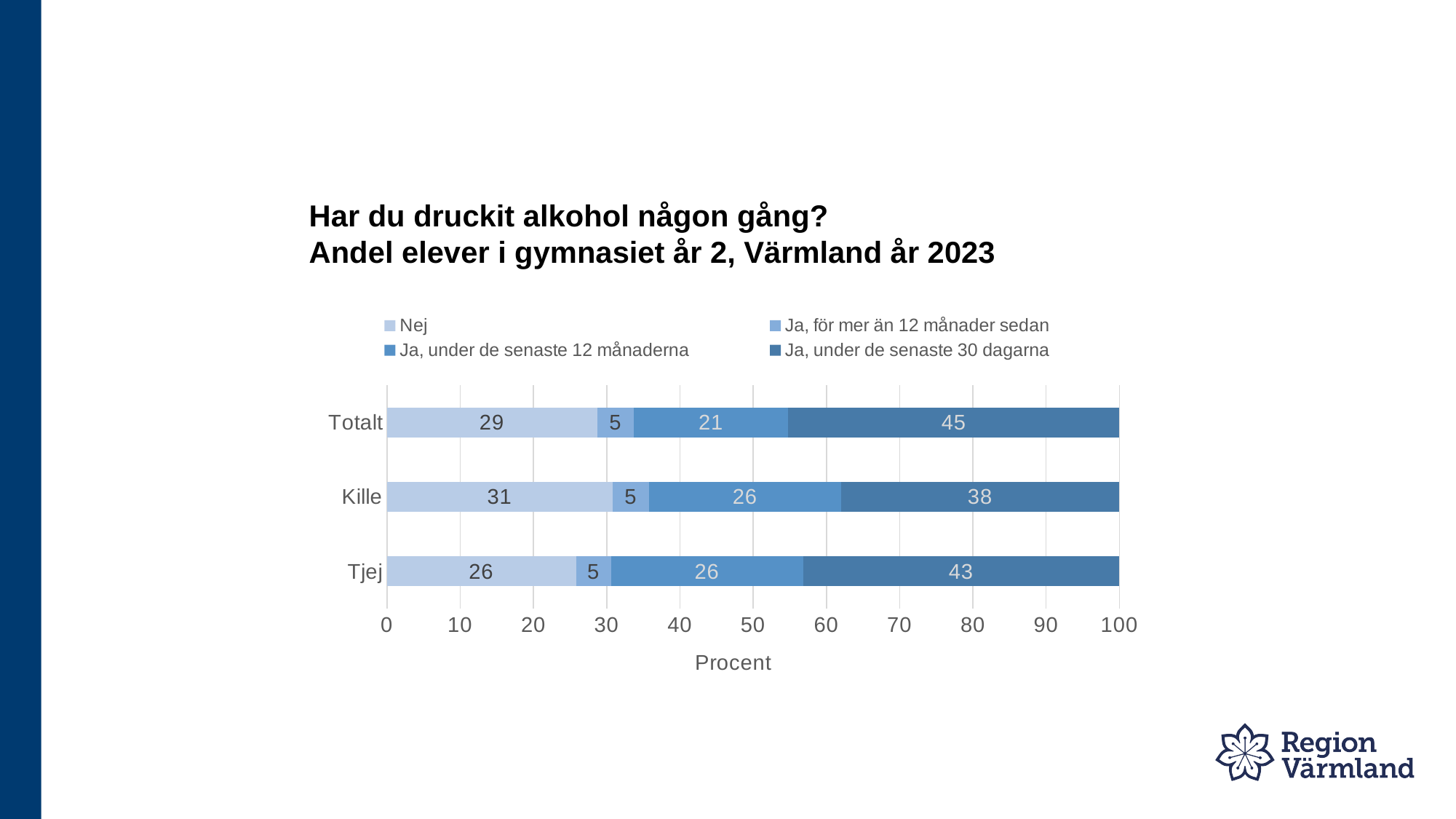
Which category has the highest value for 'Ja, under de senaste 30 dagarna'? Totalt What is the label of the horizontal axis? Procent What is the value of 'Nej' for Totalt? 29 How many series does the legend list? 4 Which is larger: the 'Nej' value for Kille or for Tjej? Kille How many categories are shown on the vertical axis? 3 What is the difference between the 'Ja, under de senaste 30 dagarna' values for Tjej and Kille? 5 What type of chart is shown on the slide? Stacked bar chart Which category has the lowest value for 'Nej'? Tjej What is the value of 'Ja, under de senaste 30 dagarna' for Kille? 38 What is the value of 'Ja, under de senaste 12 månaderna' for Tjej? 26 What is the total of the stacked bar for Kille? 100